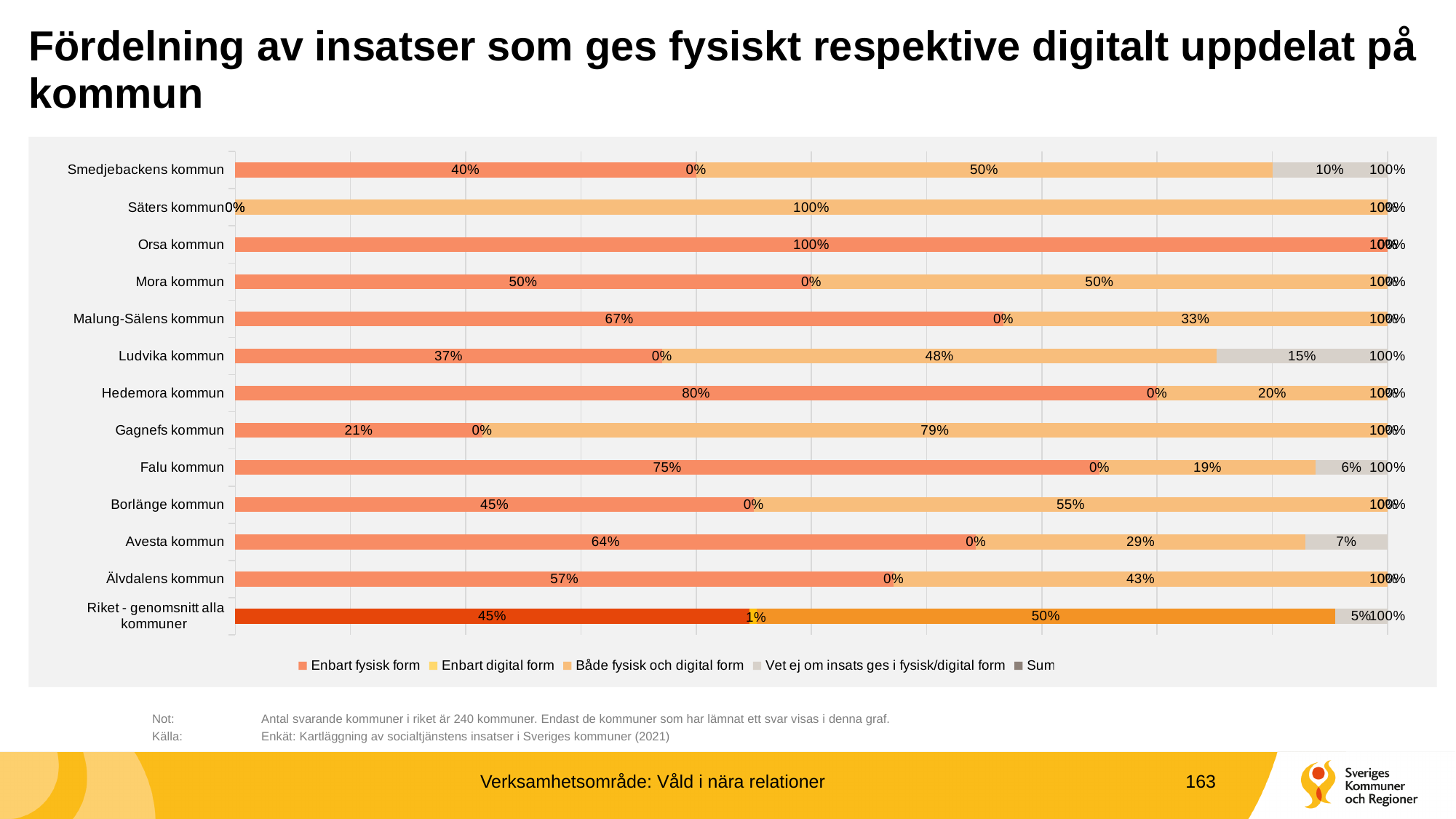
How many categories (rows) are shown on the chart? 13 What is the value for 'Enbart digital form' for 'Riket - genomsnitt alla kommuner'? 1% Which kommun has the lowest value for 'Enbart fysisk form'? Säters kommun What is the value for 'Enbart fysisk form' for Smedjebackens kommun? 40% Which kommun has the highest value for 'Enbart fysisk form'? Orsa kommun For Malung-Sälens kommun, which is larger: 'Enbart fysisk form' or 'Både fysisk och digital form'? Enbart fysisk form What is the first entry in the chart's legend? Enbart fysisk form What kind of chart is shown on the slide? Stacked bar chart What is the value for 'Vet ej om insats ges i fysisk/digital form' for Ludvika kommun? 15% What is the value for 'Både fysisk och digital form' for Hedemora kommun? 20% What is the value for 'Vet ej om insats ges i fysisk/digital form' for Falu kommun? 6% For Borlänge kommun, what is the difference between 'Både fysisk och digital form' and 'Enbart fysisk form'? 10%